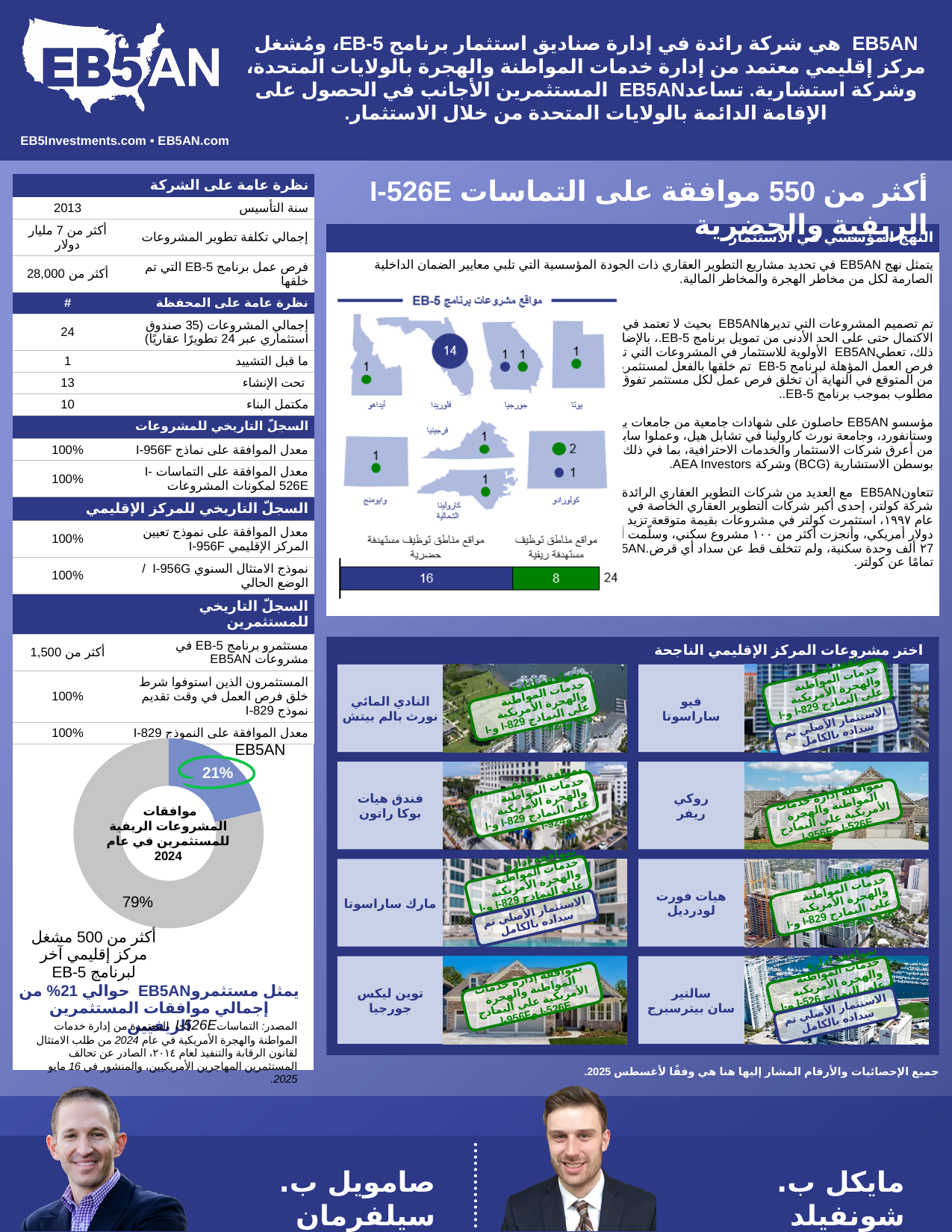
How many slices does the pie chart 'موافقات المشروعات الريفية للمستثمرين في عام 2024' have? 2 In the pie chart 'موافقات المشروعات الريفية للمستثمرين في عام 2024', what share is labelled EB5AN? 21% In the pie chart 'موافقات المشروعات الريفية للمستثمرين في عام 2024', which slice is the smallest? EB5AN In the stacked bar below the map 'مواقع مشروعات برنامج EB-5', what is the value for urban target employment areas (مواقع مناطق توظيف مستهدفة حضرية)? 16 In the stacked bar below the map 'مواقع مشروعات برنامج EB-5', what is the total of the bar? 24 In the pie chart 'موافقات المشروعات الريفية للمستثمرين في عام 2024', which is larger: the EB5AN slice or the slice for the other regional center operators? the other regional center operators In the stacked bar below the map 'مواقع مشروعات برنامج EB-5', what is the difference between the urban and rural values? 8 What kind of chart is the chart titled 'موافقات المشروعات الريفية للمستثمرين في عام 2024'? doughnut chart In the pie chart 'موافقات المشروعات الريفية للمستثمرين في عام 2024', what share is attributed to 'أكثر من 500 مشغل مركز إقليمي آخر لبرنامج EB-5'? 79% In the pie chart 'موافقات المشروعات الريفية للمستثمرين في عام 2024', how many percentage points larger is the 79% slice than the EB5AN slice? 58 In the pie chart 'موافقات المشروعات الريفية للمستثمرين في عام 2024', which slice is the largest? أكثر من 500 مشغل مركز إقليمي آخر لبرنامج EB-5 In the stacked bar below the map 'مواقع مشروعات برنامج EB-5', what is the value for rural target employment areas (مواقع مناطق توظيف مستهدفة ريفية)? 8